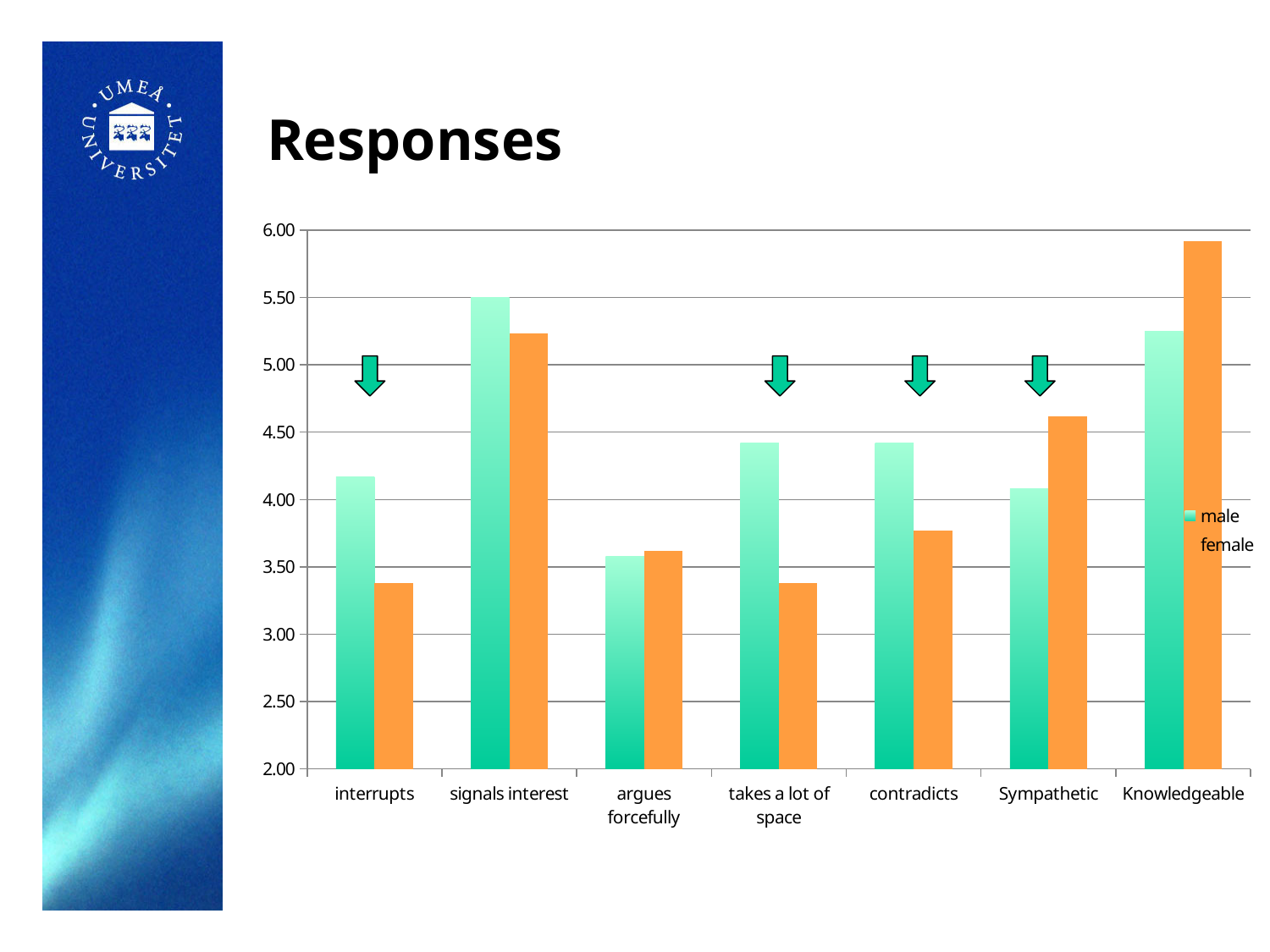
Is the female value for interrupts greater or less than 3.50? less For takes a lot of space, which series has the larger value, male or female? male Which category has the highest value for the female series? Knowledgeable What is the title of the slide containing the chart? Responses Is the female value for Knowledgeable greater or less than 5.50? greater For Sympathetic, which series has the larger value, male or female? female Is the male value for interrupts greater or less than 4.00? greater How many categories are shown on the x axis of the chart? 7 Which category has the highest value for the male series? signals interest Which category has the lowest value for the male series? argues forcefully What kind of chart is shown on the slide? bar chart How many series does the chart's legend list? 2